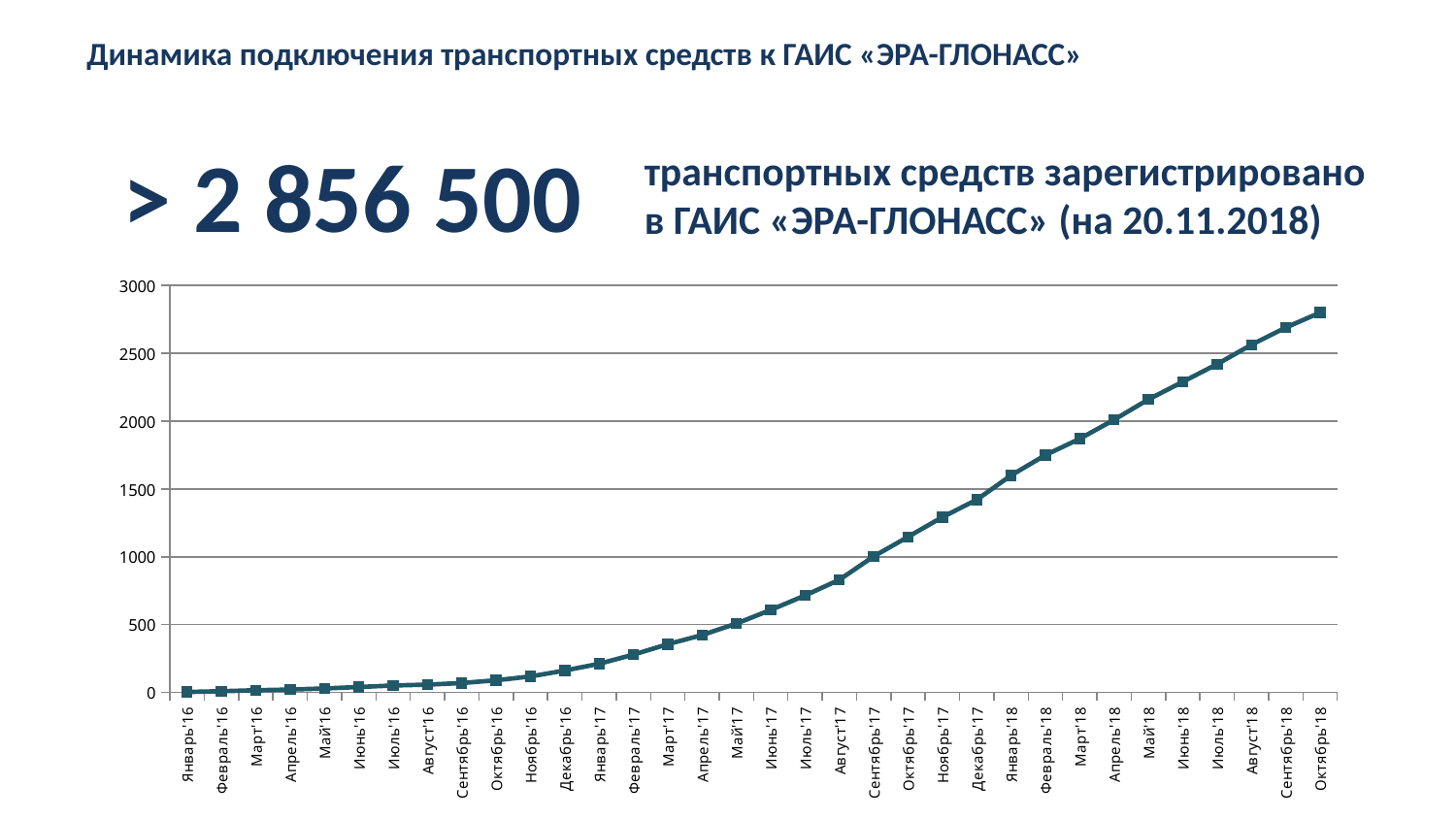
Do the values rise or fall from Январь'16 to Октябрь'18? rise How many monthly data points are plotted on the chart? 34 Which month has the lowest value on the chart? Январь'16 Is the value for Декабрь'16 greater or less than 500? less What kind of chart is shown on the slide? line chart Which month has the highest value on the chart? Октябрь'18 Is the value for Август'17 greater or less than 1000? less Is the value for Октябрь'18 greater or less than 2500? greater What is the highest tick value shown on the vertical axis? 3000 Which is larger, the value for Май'18 or the value for Ноябрь'17? Май'18